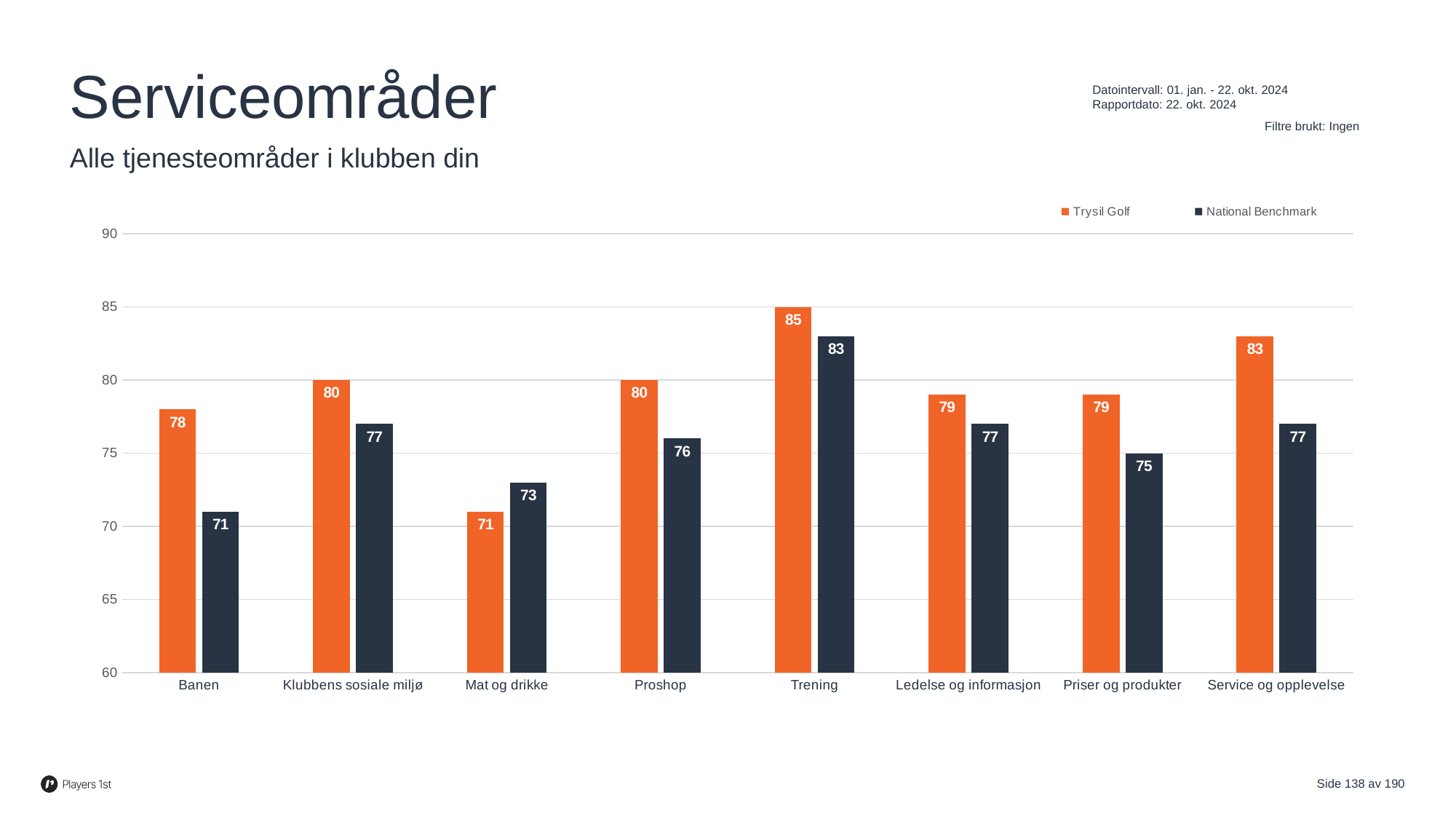
Which category has the lowest National Benchmark value? Banen What is the Trysil Golf value for Trening? 85 How many categories are shown on the x axis? 8 How many series does the legend list? 2 What is the National Benchmark value for Mat og drikke? 73 What kind of chart is shown on the slide? Bar chart What colour are the Trysil Golf bars? Orange Which is larger for Mat og drikke: Trysil Golf or National Benchmark? National Benchmark Is the National Benchmark value for Priser og produkter greater or less than 80? less What is the difference between the Trysil Golf and National Benchmark values for Banen? 7 Which category has the highest Trysil Golf value? Trening What is the Trysil Golf value for Service og opplevelse? 83